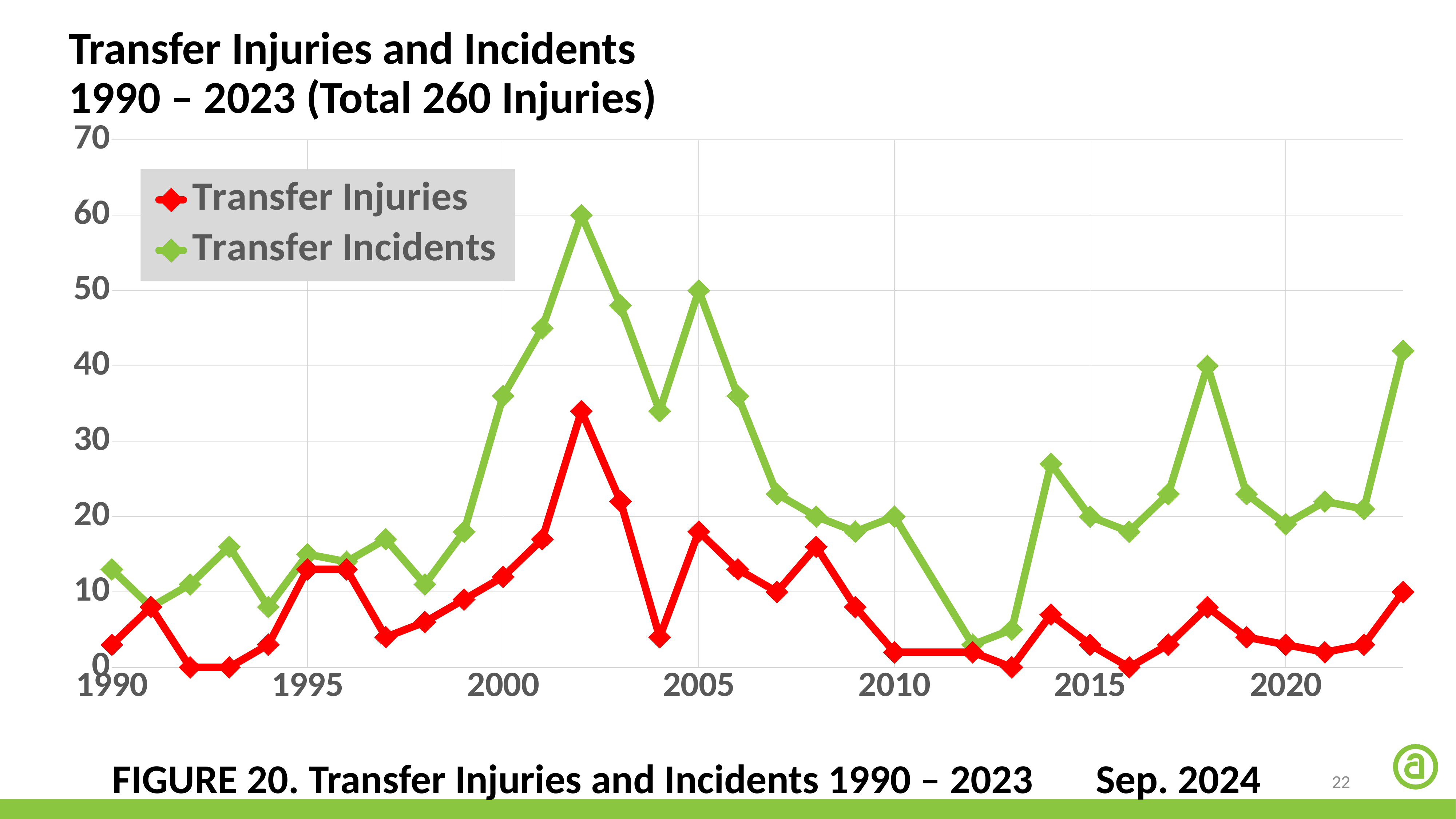
What is the value of Transfer Incidents in 2005? 50 What is the value of Transfer Incidents in 2002? 60 In which year does the Transfer Incidents series reach its highest value? 2002 Do Transfer Incidents rise or fall from 2002 to 2004? fall Is the value for Transfer Injuries in 2002 greater or less than 30? greater What is the value of Transfer Injuries in 1992? 0 Is the value for Transfer Incidents in 2001 greater or less than 40? greater What is the difference between Transfer Incidents in 2002 and Transfer Incidents in 2005? 10 In which year does the Transfer Injuries series reach its highest value? 2002 How many series does the legend list? 2 What kind of chart is shown on the slide? line chart Which is larger: Transfer Incidents in 2002 or Transfer Incidents in 2005? 2002